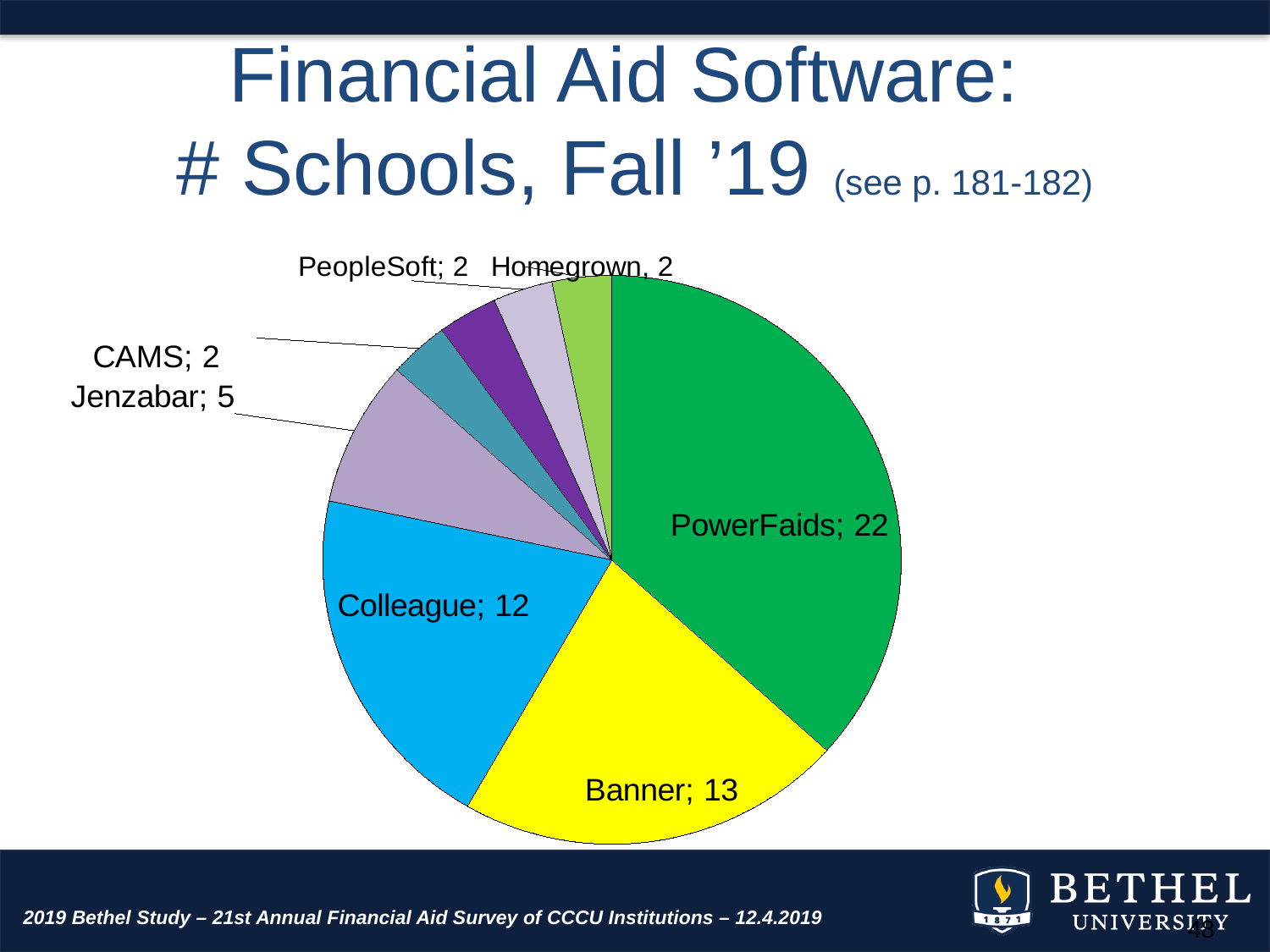
How many schools use Colleague? 12 How many schools use Banner? 13 Which is used by more schools, Banner or Colleague? Banner Which financial aid software is used by the most schools? PowerFaids How many schools use CAMS? 2 What is the difference between the number of schools using Colleague and the number using Jenzabar? 7 What kind of chart is shown on the slide? pie chart How many schools use PowerFaids? 22 What is the title of the chart on the slide? Financial Aid Software: # Schools, Fall '19 How many schools use Homegrown financial aid software? 2 How many schools use Jenzabar? 5 What is the difference between the number of schools using PowerFaids and the number using Banner? 9